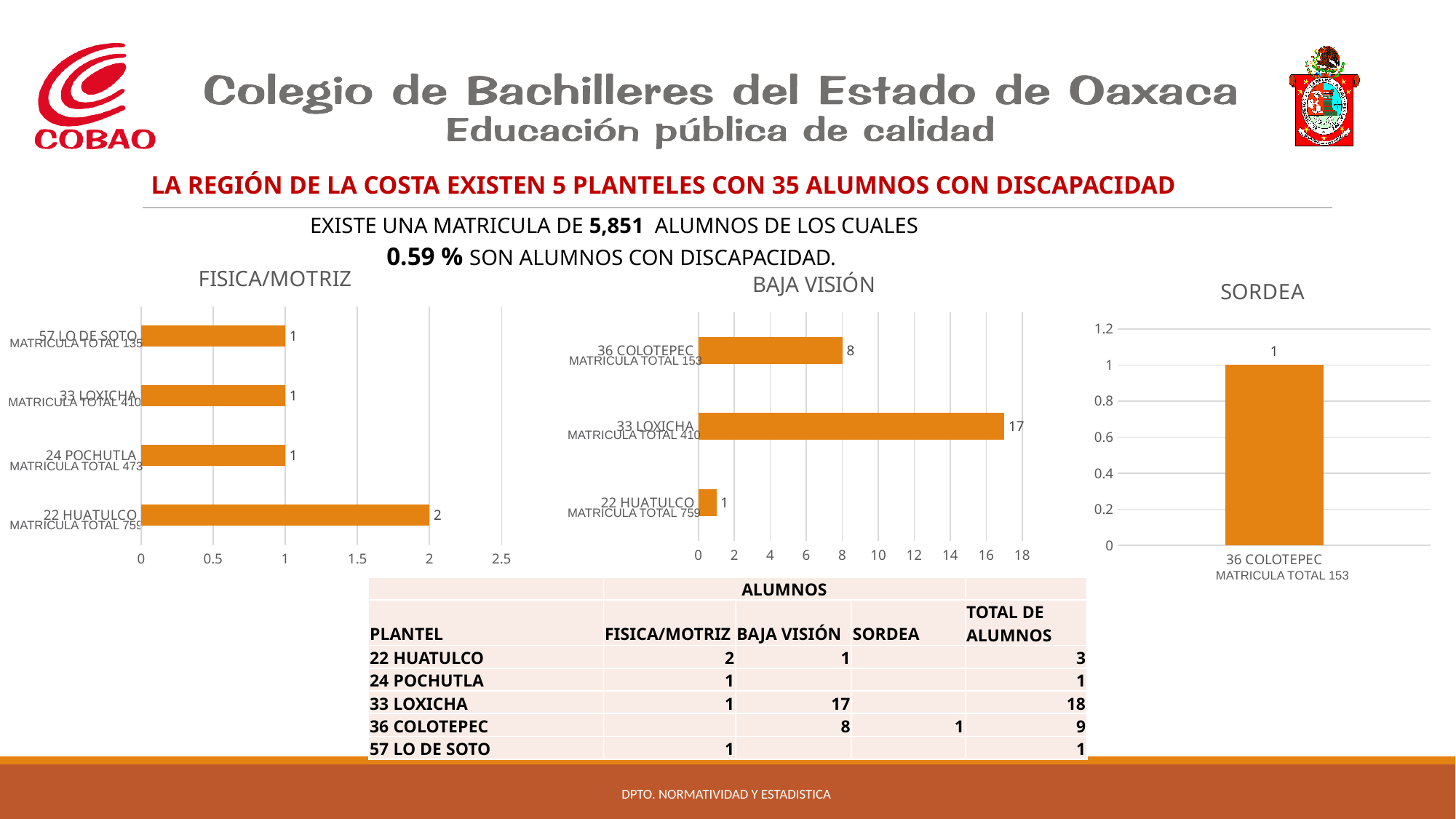
In the BAJA VISIÓN chart, what is the value for 33 LOXICHA? 17 In the BAJA VISIÓN chart, which plantel has the lowest value? 22 HUATULCO In the SORDEA chart, what is the value for 36 COLOTEPEC? 1 What kind of chart is the FISICA/MOTRIZ chart? Bar chart How many planteles are shown in the FISICA/MOTRIZ chart? 4 In the FISICA/MOTRIZ chart, which plantel has the highest value? 22 HUATULCO In the FISICA/MOTRIZ chart, what is the value for 22 HUATULCO? 2 In the BAJA VISIÓN chart, what is the value for 36 COLOTEPEC? 8 In the BAJA VISIÓN chart, which is larger, the value for 36 COLOTEPEC or the value for 22 HUATULCO? 36 COLOTEPEC How many planteles are shown in the BAJA VISIÓN chart? 3 What is the title of the chart on the right side of the slide? SORDEA In the BAJA VISIÓN chart, what is the difference between the values for 33 LOXICHA and 36 COLOTEPEC? 9